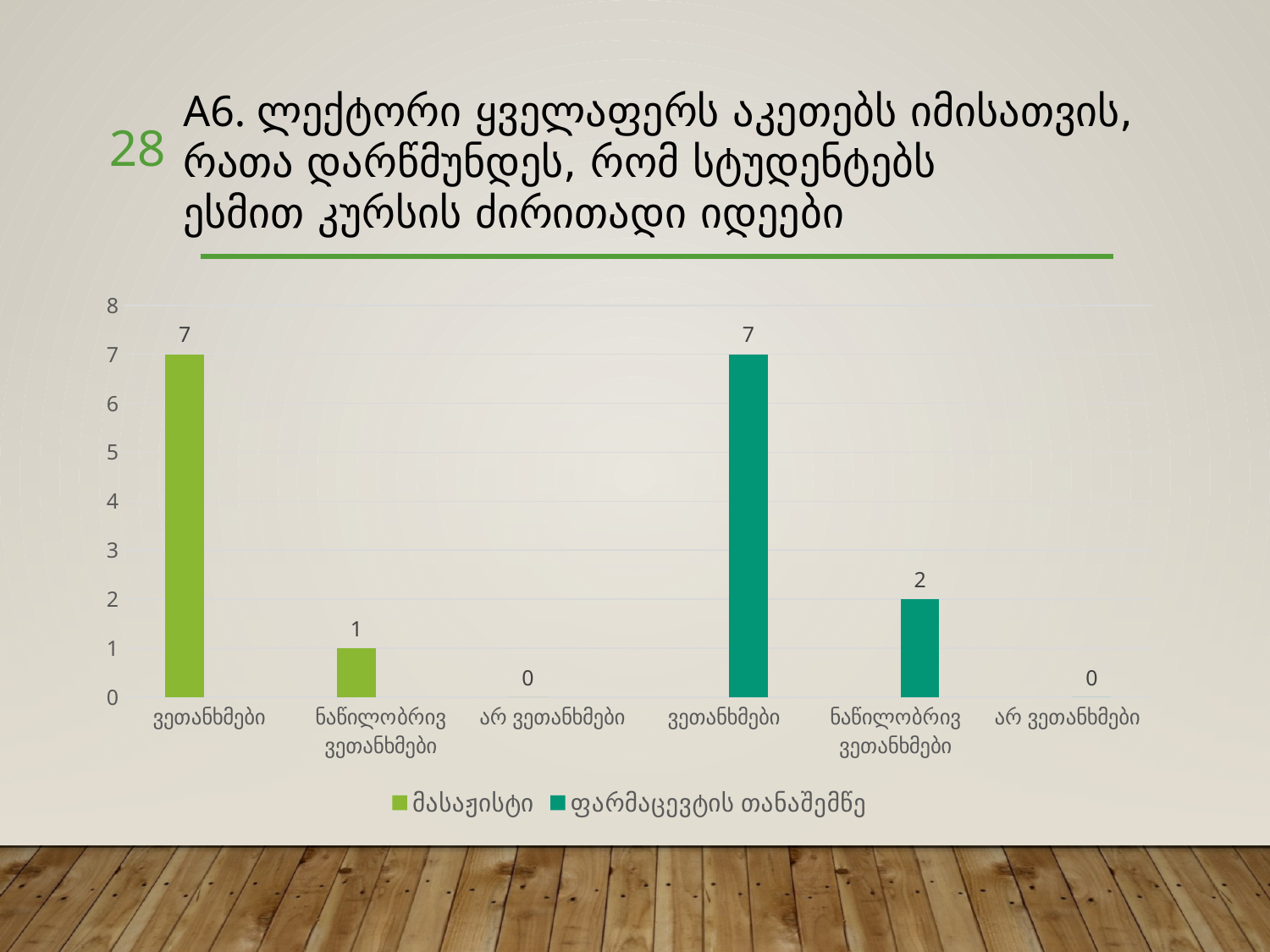
What is the total of the three values in the მასაჟისტი series? 8 What is the value for ნაწილობრივ ვეთანხმები in the ფარმაცევტის თანაშემწე series? 2 Which is larger: ნაწილობრივ ვეთანხმები for მასაჟისტი or ნაწილობრივ ვეთანხმები for ფარმაცევტის თანაშემწე? ფარმაცევტის თანაშემწე What is the difference between the ვეთანხმები and ნაწილობრივ ვეთანხმები values in the ფარმაცევტის თანაშემწე series? 5 What is the value for ნაწილობრივ ვეთანხმები in the მასაჟისტი series? 1 Which category has the highest value in the ფარმაცევტის თანაშემწე series? ვეთანხმები How many series does the legend list? 2 What kind of chart is shown on the slide? bar chart What is the value for არ ვეთანხმები in the ფარმაცევტის თანაშემწე series? 0 Which category has the lowest value in the მასაჟისტი series? არ ვეთანხმები What is the value for ვეთანხმები in the მასაჟისტი series? 7